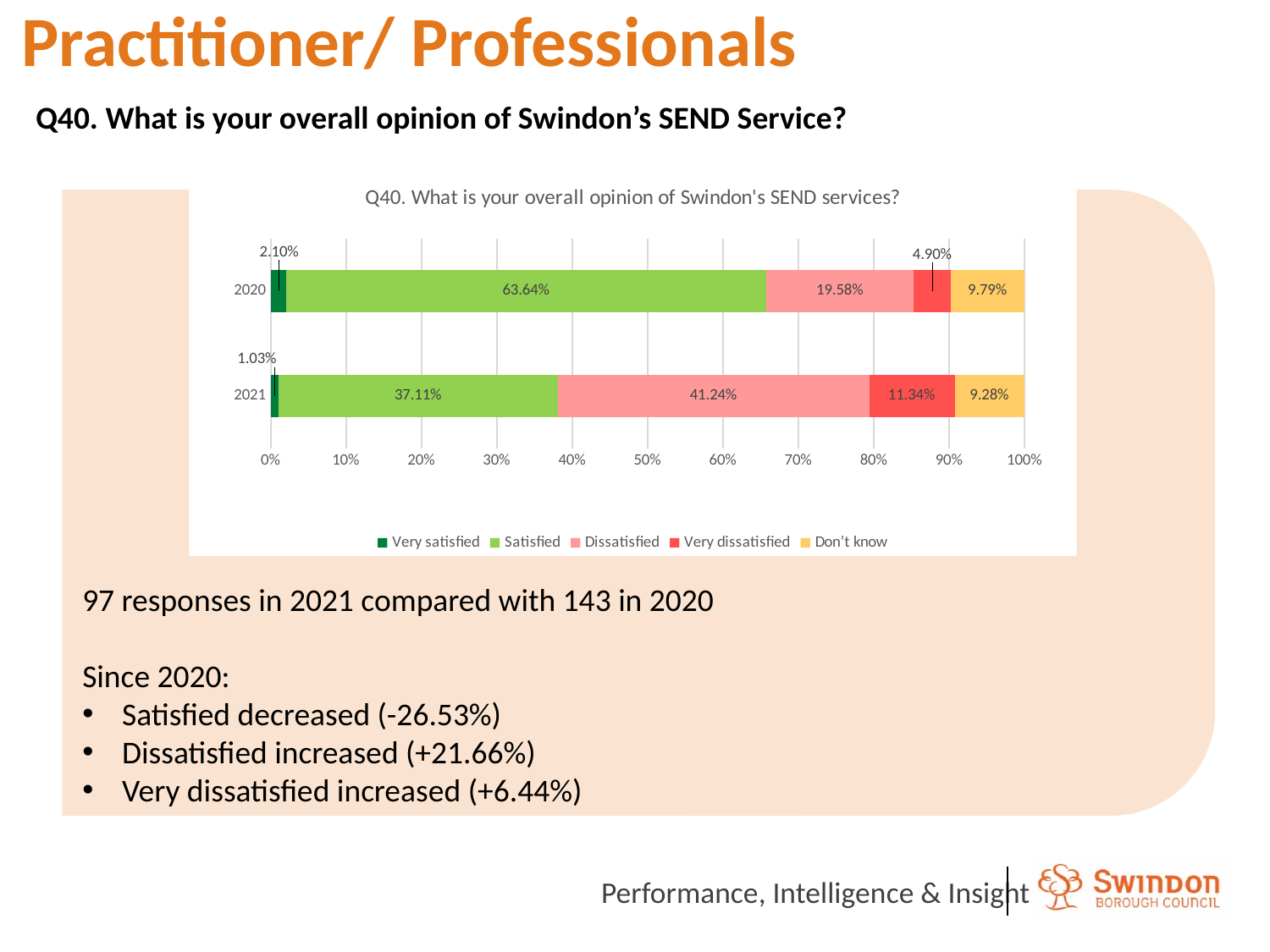
Which year has the larger Satisfied share, 2020 or 2021? 2020 What percentage of 2021 respondents were Dissatisfied? 41.24% What kind of chart is shown on the slide? Stacked bar chart How many series does the legend list? 5 What is the Very satisfied value for 2020? 2.10% What is the Very dissatisfied value for 2021? 11.34% What colour represents the Don't know series in the chart? Yellow How many years (categories) are plotted in the chart? 2 What percentage of 2020 respondents were Satisfied? 63.64% Which response category has the smallest share in 2021? Very satisfied What is the Don't know value for 2021? 9.28% What is the difference between the Dissatisfied values for 2021 and 2020? 21.66%